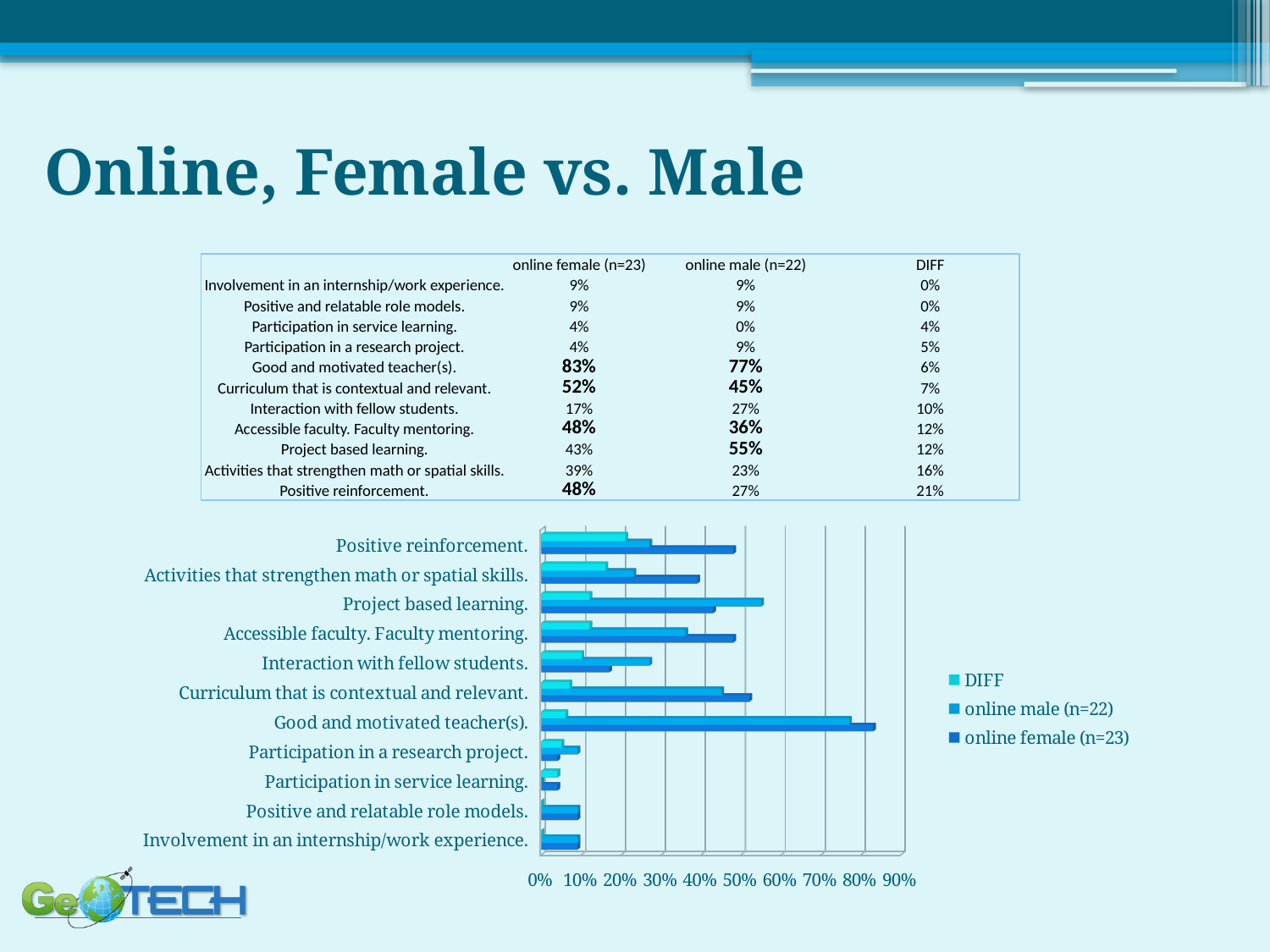
According to the table, what is the online female (n=23) value for Good and motivated teacher(s)? 83% What is the title of the slide containing the chart? Online, Female vs. Male What is the difference between the online female (n=23) and online male (n=22) values for Accessible faculty. Faculty mentoring? 12% Which category has the largest DIFF value? Positive reinforcement. How many categories are plotted on the chart? 11 Which category has the highest online female (n=23) value? Good and motivated teacher(s). What kind of chart is shown on the slide? bar chart Is the online female (n=23) bar for Curriculum that is contextual and relevant greater or less than 40%? greater According to the table, what is the DIFF value for Positive reinforcement? 21% According to the table, what is the online male (n=22) value for Project based learning? 55% How many series does the chart legend list? 3 For Project based learning, which is larger: the online female (n=23) value or the online male (n=22) value? online male (n=22)